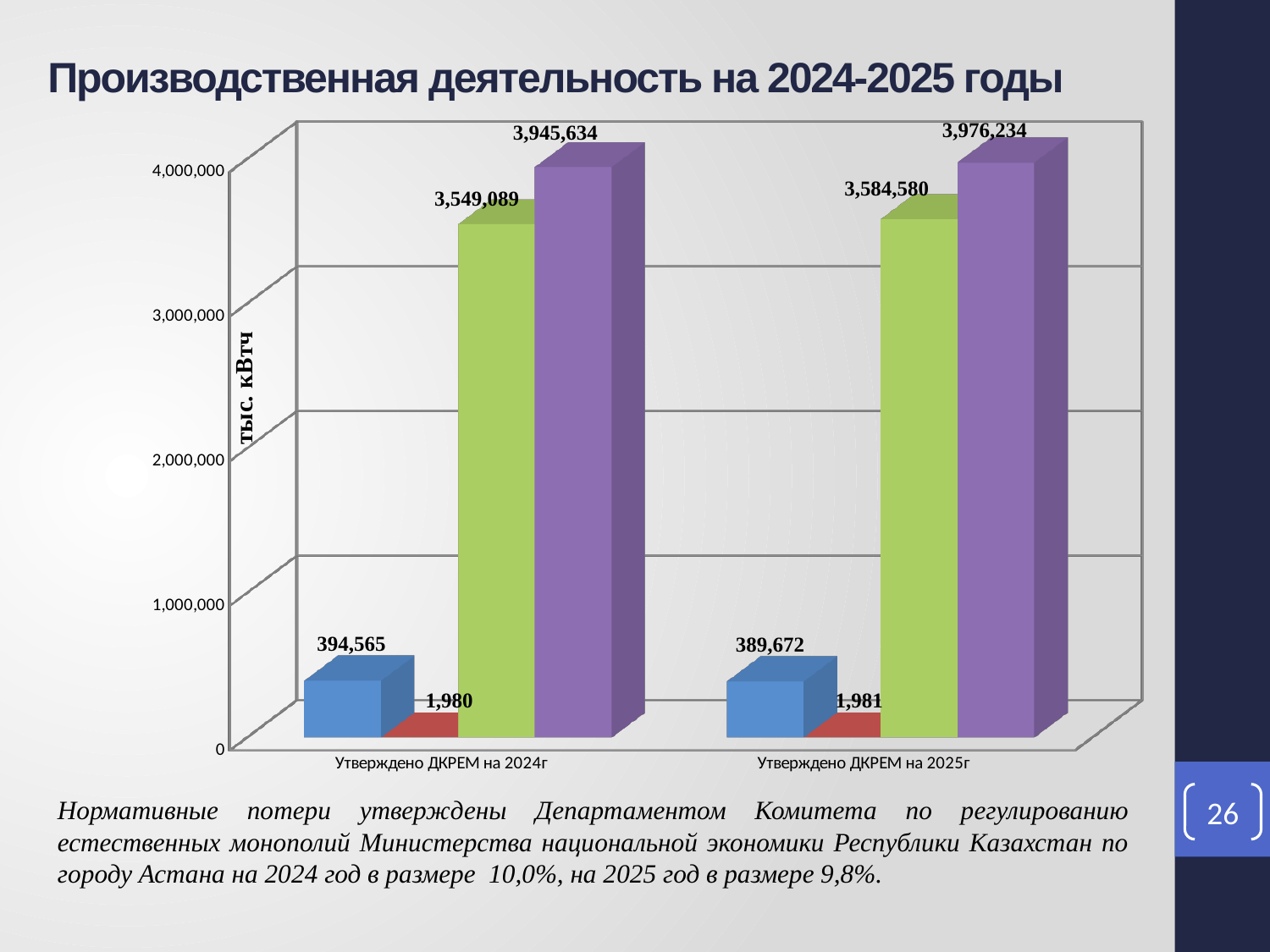
What is the value of the red bar for "Утверждено ДКРЕМ на 2025г"? 1,981 What is the label of the vertical axis of the chart? тыс. кВтч What is the value of the blue bar for "Утверждено ДКРЕМ на 2024г"? 394,565 Which bar has the highest value in the chart? the purple bar for Утверждено ДКРЕМ на 2025г (3,976,234) Which is larger: the blue bar for "Утверждено ДКРЕМ на 2024г" or the blue bar for "Утверждено ДКРЕМ на 2025г"? Утверждено ДКРЕМ на 2024г What is the value of the green bar for "Утверждено ДКРЕМ на 2025г"? 3,584,580 Is the value of the green bar for "Утверждено ДКРЕМ на 2025г" greater or less than 3,000,000? greater How many categories are shown on the x axis of the chart? 2 What is the value of the purple bar for "Утверждено ДКРЕМ на 2024г"? 3,945,634 Which bar has the lowest value in the chart? the red bar for Утверждено ДКРЕМ на 2024г (1,980) What type of chart is shown on the slide? bar chart What is the difference between the purple bar and the green bar for "Утверждено ДКРЕМ на 2024г"? 396,545